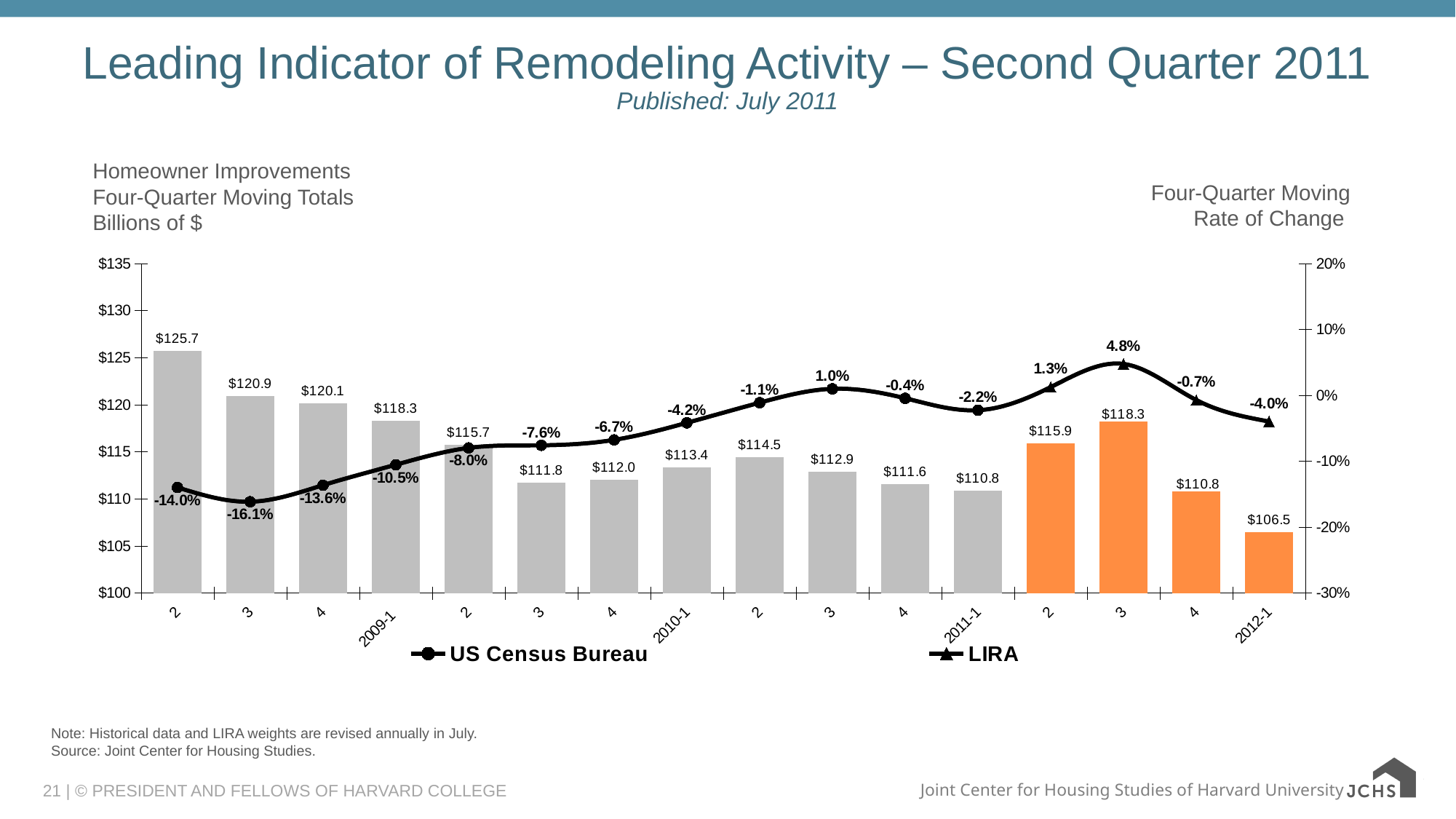
What is the difference between the bar values for 2011-1 and 2012-1? $4.3 How many series does the legend list? 2 What kind of chart is this? A combination bar and line chart What is the highest four-quarter moving rate of change plotted on the line? 4.8% Which quarter has the highest four-quarter moving total bar? The first quarter shown (labeled 2), $125.7 What is the bar value for 2011-1? $110.8 How many quarters are plotted along the x axis? 16 What is the lowest four-quarter moving rate of change plotted on the line? -16.1% What is the four-quarter moving total (bar value) for 2009-1? $118.3 Which quarter has the lowest four-quarter moving total bar? 2012-1, $106.5 What is the four-quarter moving rate of change shown for 2012-1? -4.0% Which has the larger four-quarter moving total, 2010-1 or 2011-1? 2010-1